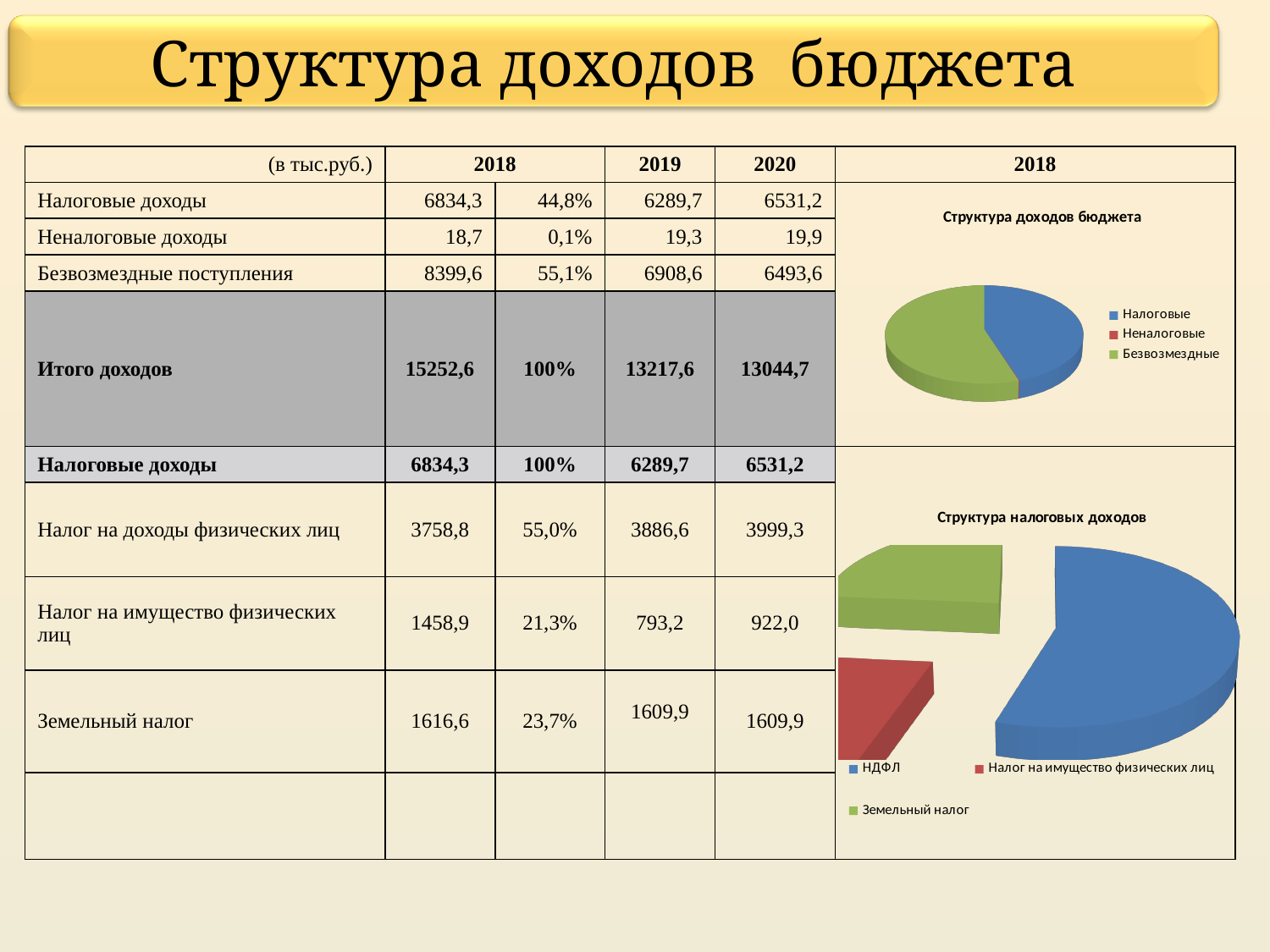
In the top chart "Структура доходов бюджета", how many entries does the legend list? 3 In the top chart "Структура доходов бюджета", which slice is larger: Налоговые or Безвозмездные? Безвозмездные Which year do the pie charts on the slide represent, according to the header above them? 2018 In the bottom chart "Структура налоговых доходов", how many entries does the legend list? 3 What kind of chart is the bottom chart titled "Структура налоговых доходов"? pie chart In the bottom chart "Структура налоговых доходов", which category has the smallest slice? Налог на имущество физических лиц In the top chart "Структура доходов бюджета", which category has the smallest slice? Неналоговые In the bottom chart "Структура налоговых доходов", which slice is larger: НДФЛ or Земельный налог? НДФЛ In the bottom chart "Структура налоговых доходов", what colour is the НДФЛ slice? blue In the top chart "Структура доходов бюджета", which category has the largest slice? Безвозмездные What kind of chart is the top chart titled "Структура доходов бюджета"? pie chart In the bottom chart "Структура налоговых доходов", which category has the largest slice? НДФЛ